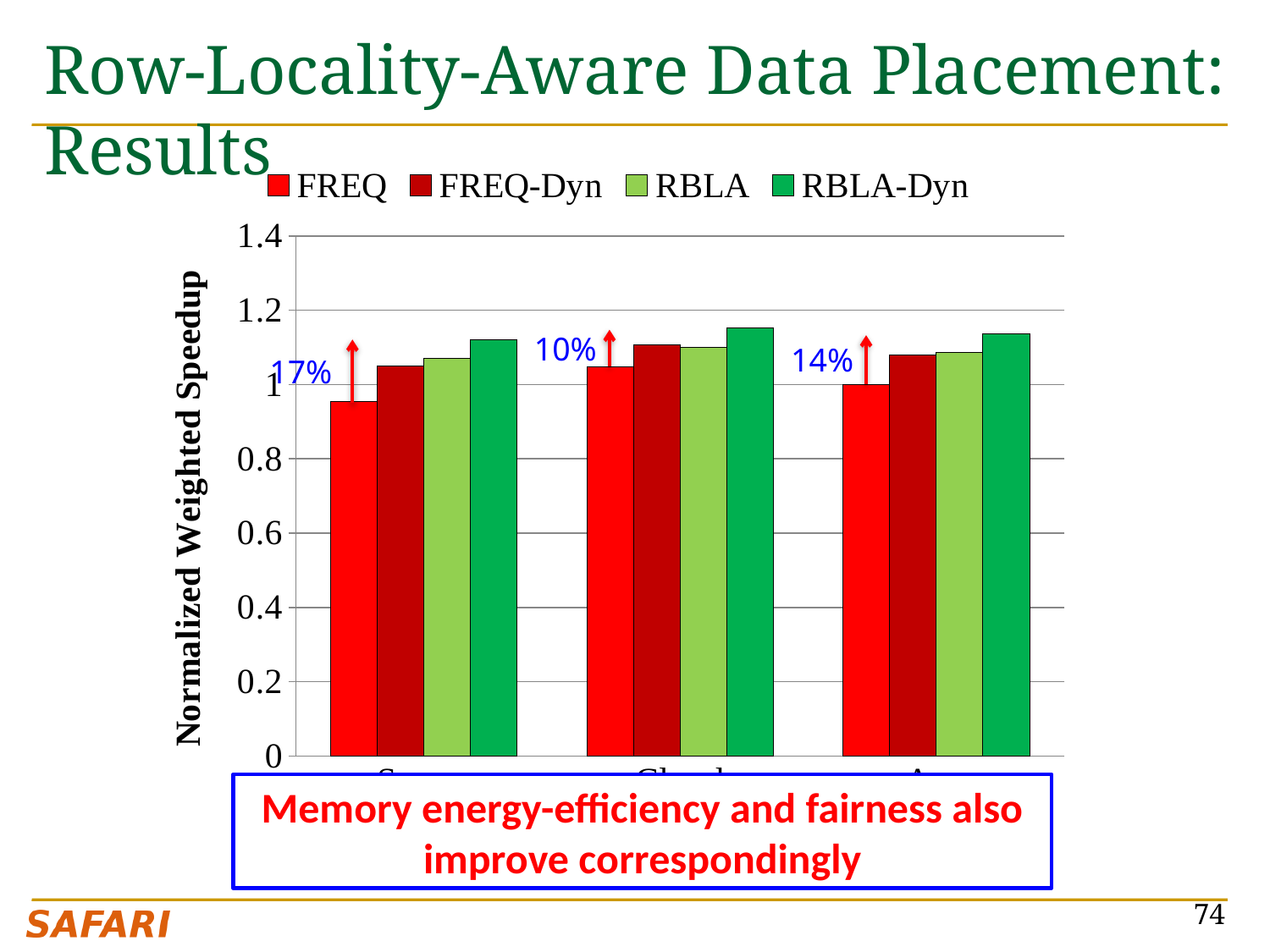
In the leftmost group, which is larger: the FREQ bar or the RBLA-Dyn bar? RBLA-Dyn What kind of chart is shown on the slide? bar chart What is the title of the chart's vertical axis? Normalized Weighted Speedup How many groups of bars are plotted in the chart? 3 Is the RBLA-Dyn value in the middle group greater or less than 1.2? less Which series has the tallest bar in the leftmost group of bars? RBLA-Dyn Which series has the shortest bar in the rightmost group of bars? FREQ Which series has the tallest bar in the middle group of bars? RBLA-Dyn Which series has the shortest bar in the leftmost group of bars? FREQ How many series does the chart's legend list? 4 Is the FREQ value in the leftmost group greater or less than 1? less Is the RBLA-Dyn value in the leftmost group greater or less than 1? greater